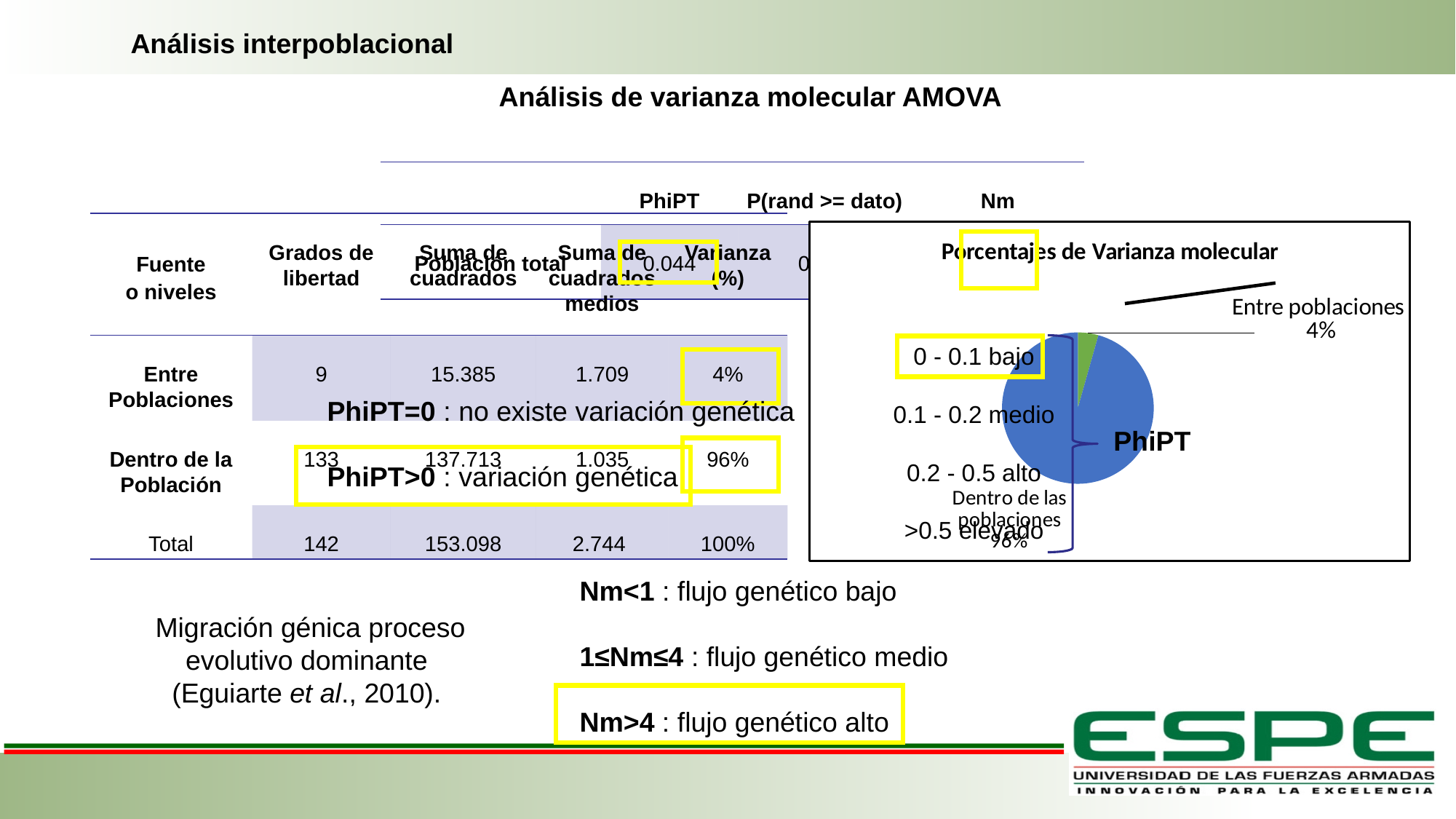
Which slice of the pie chart is the largest? Dentro de las poblaciones How many slices does the pie chart have? 2 What kind of chart is shown on the slide? pie chart Which is larger in the pie chart, "Entre poblaciones" or "Dentro de las poblaciones"? Dentro de las poblaciones What share of the pie does "Dentro de las poblaciones" represent? 96% What is the difference in percentage points between the "Dentro de las poblaciones" slice and the "Entre poblaciones" slice? 92% What share of the pie does "Entre poblaciones" represent? 4% What colour is the "Entre poblaciones" slice in the pie chart? green Which slice of the pie chart is the smallest? Entre poblaciones What is the title of the pie chart? Porcentajes de Varianza molecular